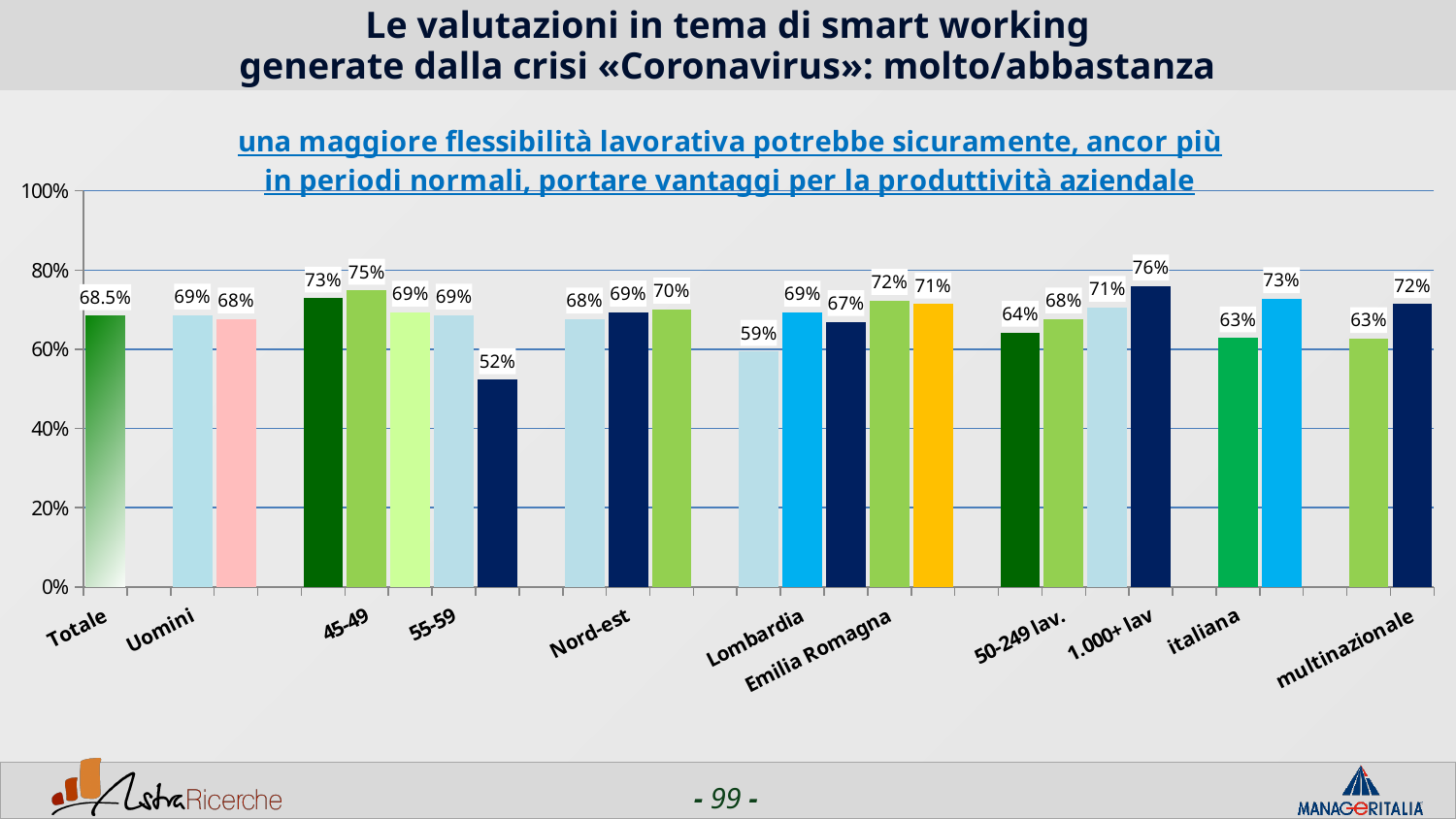
What is the value for 1.000+ lav? 76% Which labelled category has the highest value? 1.000+ lav What is the value for multinazionale? 72% What is the difference between the values for 1.000+ lav and italiana? 13 percentage points What is the highest value shown on the y axis? 100% Which is larger, the value for Emilia Romagna or the value for 50-249 lav.? Emilia Romagna What kind of chart is shown on the slide? bar chart What is the value for Emilia Romagna? 72% Is the value for Totale greater or less than 60%? greater What is the value for Uomini? 69% What is the value for italiana? 63% What is the value for Totale? 68.5%